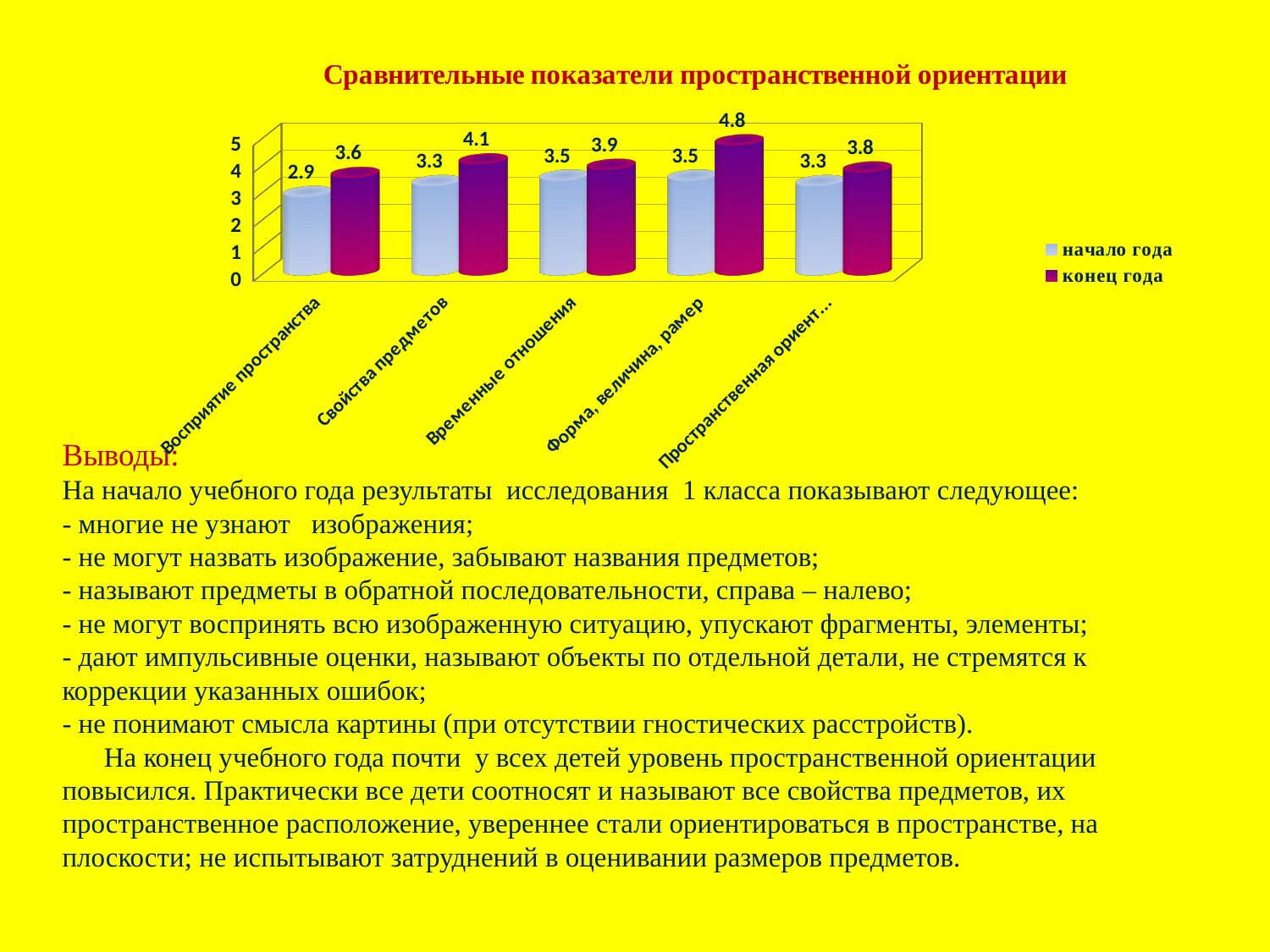
Which category has the lowest «начало года» value? Восприятие пространства What is the value for «конец года» in the «Свойства предметов» category? 4.1 What kind of chart is shown on the slide? Bar chart What is the difference between the «конец года» and «начало года» values for «Форма, величина, рамер»? 1.3 What is the value for «начало года» in the «Восприятие пространства» category? 2.9 Which category has the highest «конец года» value? Форма, величина, рамер Which is larger: the «конец года» value for «Свойства предметов» or for «Временные отношения»? Свойства предметов What is the value for «начало года» in the «Временные отношения» category? 3.5 What is the title of the chart? Сравнительные показатели пространственной ориентации How many series does the legend list? 2 What is the difference between the «конец года» and «начало года» values for «Восприятие пространства»? 0.7 How many categories are shown on the x axis of the chart? 5